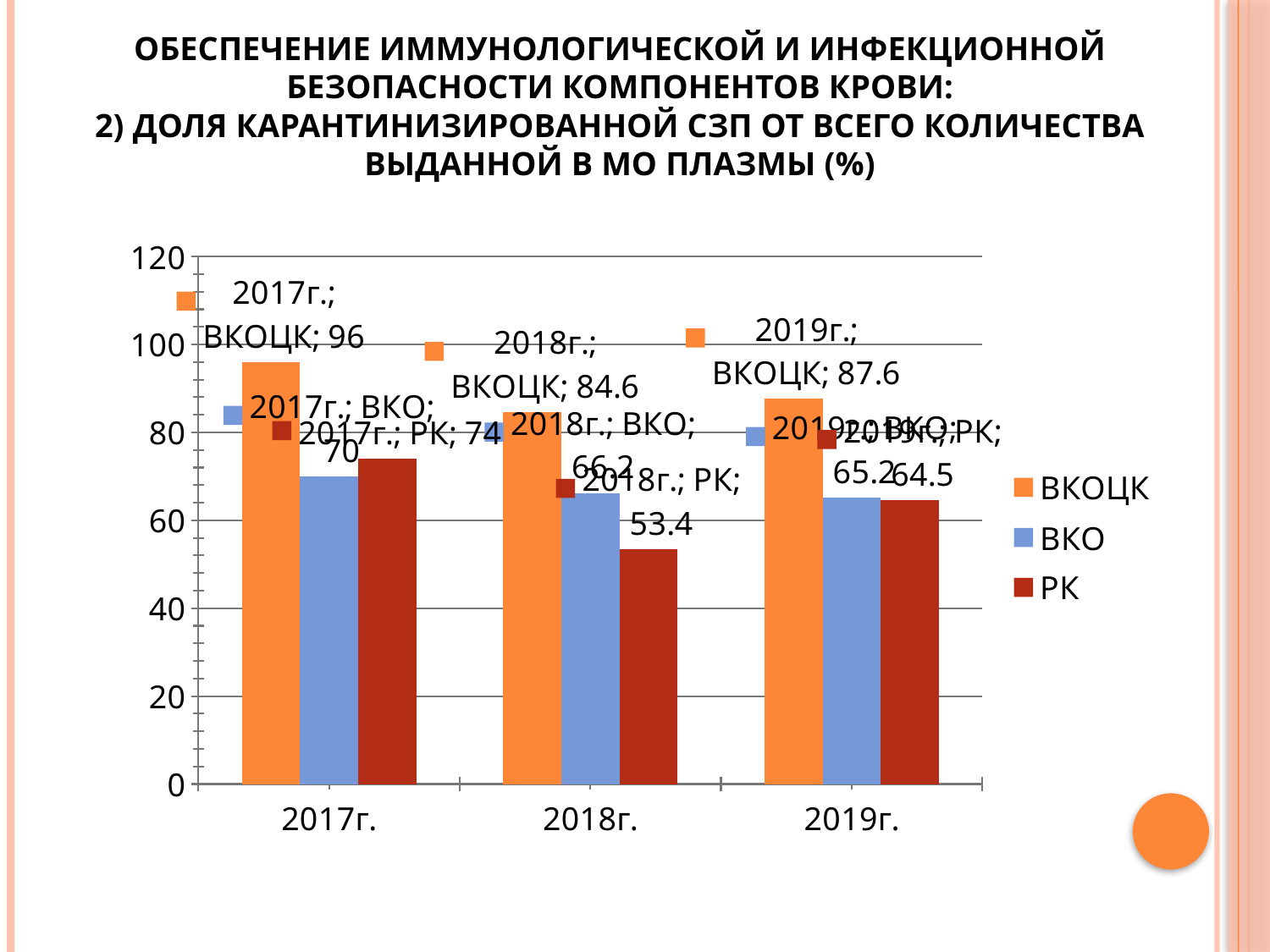
What is the value for РК in 2018г.? 53.4 In which year is the ВКОЦК value highest? 2017г. How many series does the legend list? 3 Does the ВКО value fall or rise from 2017г. to 2019г.? fall What is the difference between the ВКОЦК and ВКО values in 2017г.? 26 What type of chart is shown on the slide? bar chart Which is larger in 2017г., the ВКО value or the РК value? РК What is the value for ВКОЦК in 2017г.? 96 What is the value for ВКОЦК in 2019г.? 87.6 How many year categories are shown on the x axis? 3 In which year is the РК value lowest? 2018г. What is the value for ВКО in 2018г.? 66.2